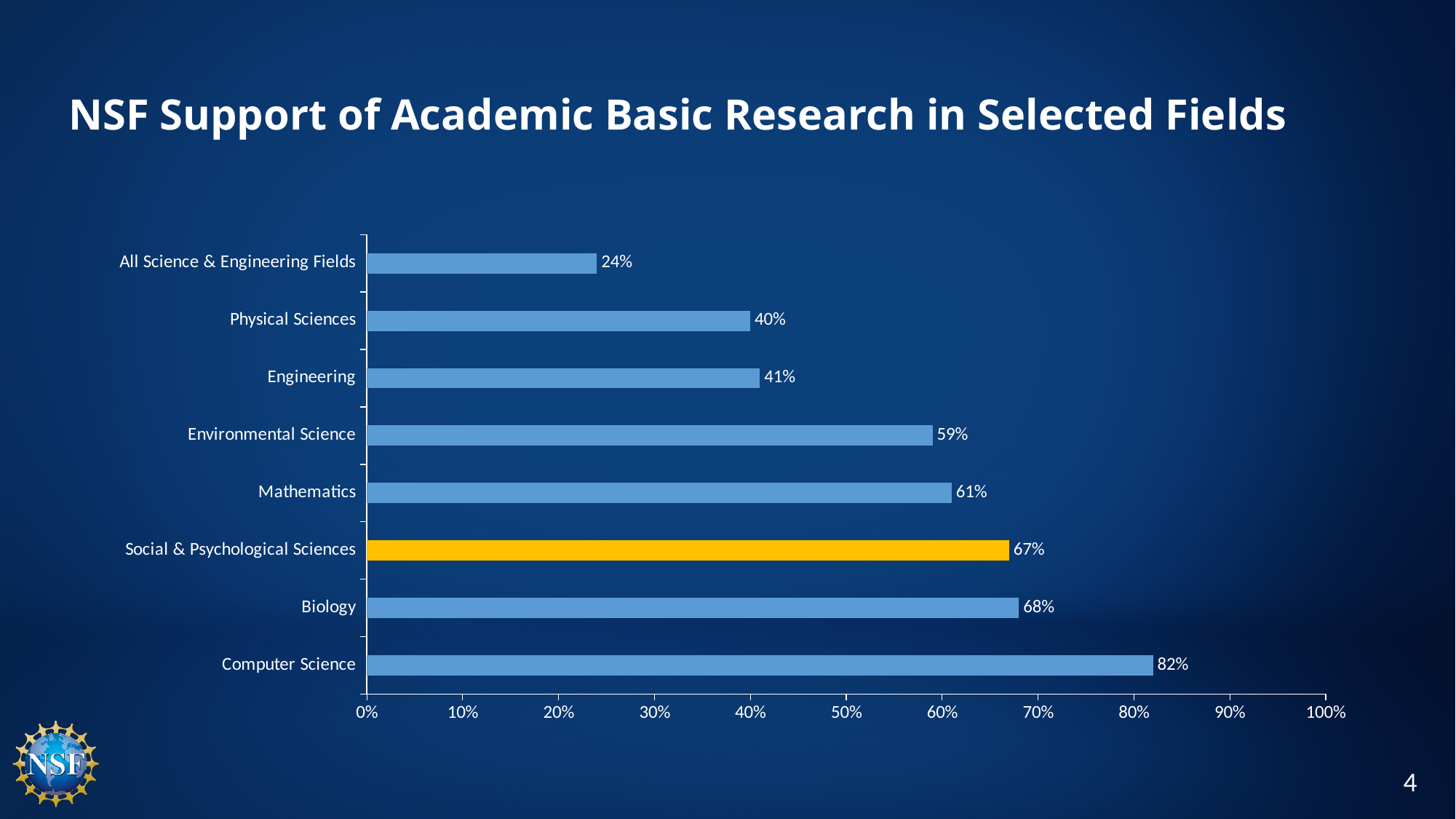
What is the value for Environmental Science? 59% Which category has the lowest value? All Science & Engineering Fields Which field has the highest value? Computer Science How many categories are shown in the chart? 8 What is the difference between the values for Computer Science and Biology? 14% What is the value for Social & Psychological Sciences? 67% What is the value for All Science & Engineering Fields? 24% Which bar is highlighted in a different colour (yellow) from the others? Social & Psychological Sciences What kind of chart is shown on the slide? Bar chart What is the value for Computer Science? 82% What is the difference between the values for Mathematics and Physical Sciences? 21% Which is larger, the value for Engineering or the value for Environmental Science? Environmental Science